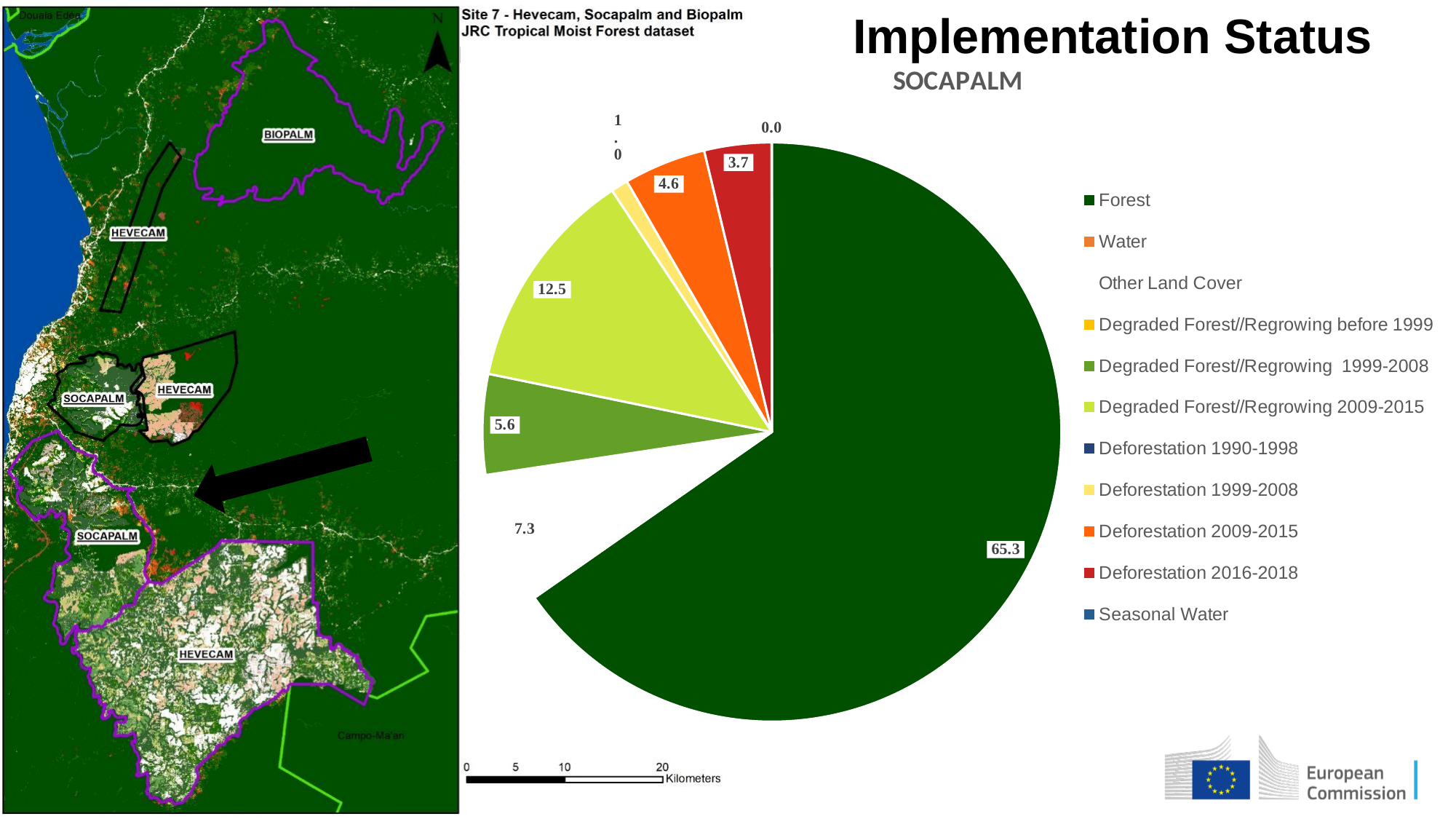
In the SOCAPALM pie chart, what is the value for Deforestation 2009-2015? 4.6 What colour is the Forest slice in the SOCAPALM pie chart? dark green Which category has the largest slice in the SOCAPALM pie chart? Forest In the SOCAPALM pie chart, what is the value for Deforestation 2016-2018? 3.7 In the SOCAPALM pie chart, what is the difference between the Forest value and the Degraded Forest//Regrowing 2009-2015 value? 52.8 In the SOCAPALM pie chart, which is larger: Degraded Forest//Regrowing 2009-2015 or Degraded Forest//Regrowing 1999-2008? Degraded Forest//Regrowing 2009-2015 In the SOCAPALM pie chart, what is the value for Forest? 65.3 What type of chart is shown under the heading SOCAPALM? pie chart In the SOCAPALM pie chart, what is the value for Degraded Forest//Regrowing 2009-2015? 12.5 In the SOCAPALM pie chart, what is the difference between Deforestation 2009-2015 and Deforestation 2016-2018? 0.9 In the SOCAPALM pie chart, what is the value for Degraded Forest//Regrowing 1999-2008? 5.6 How many entries does the legend of the SOCAPALM pie chart list? 11